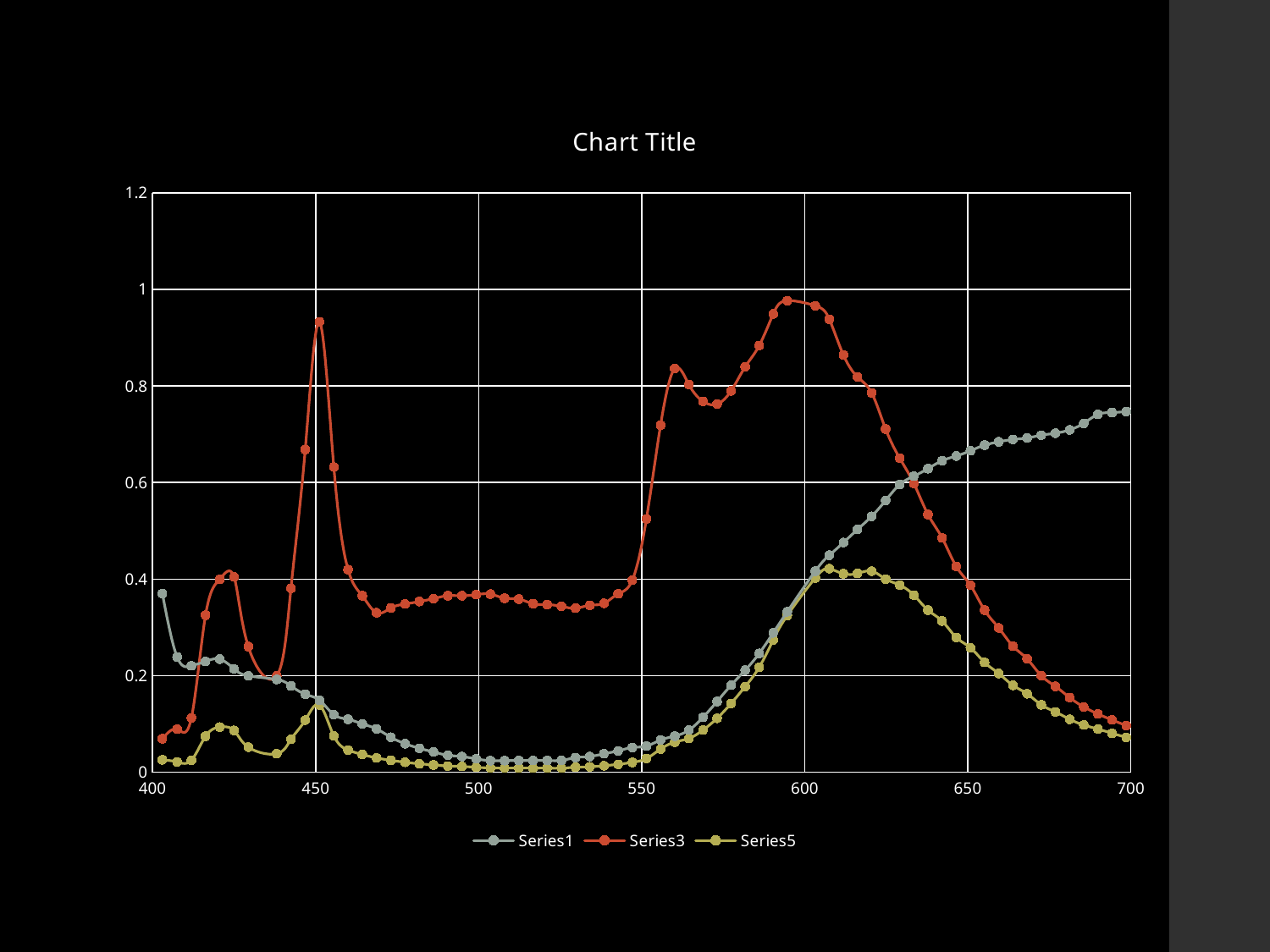
Is the value of Series1 at 500 greater or less than 0.2? less What kind of chart is shown on the slide? line chart At 450, which series has the larger value, Series3 or Series1? Series3 Which series is drawn in red? Series3 Is the value of Series5 at 650 greater or less than 0.4? less Is the value of Series5 at 500 greater or less than 0.2? less What is the title of the chart? Chart Title Which series reaches the highest value anywhere on the chart? Series3 How many series does the legend list? 3 At 700, which series has the larger value, Series1 or Series3? Series1